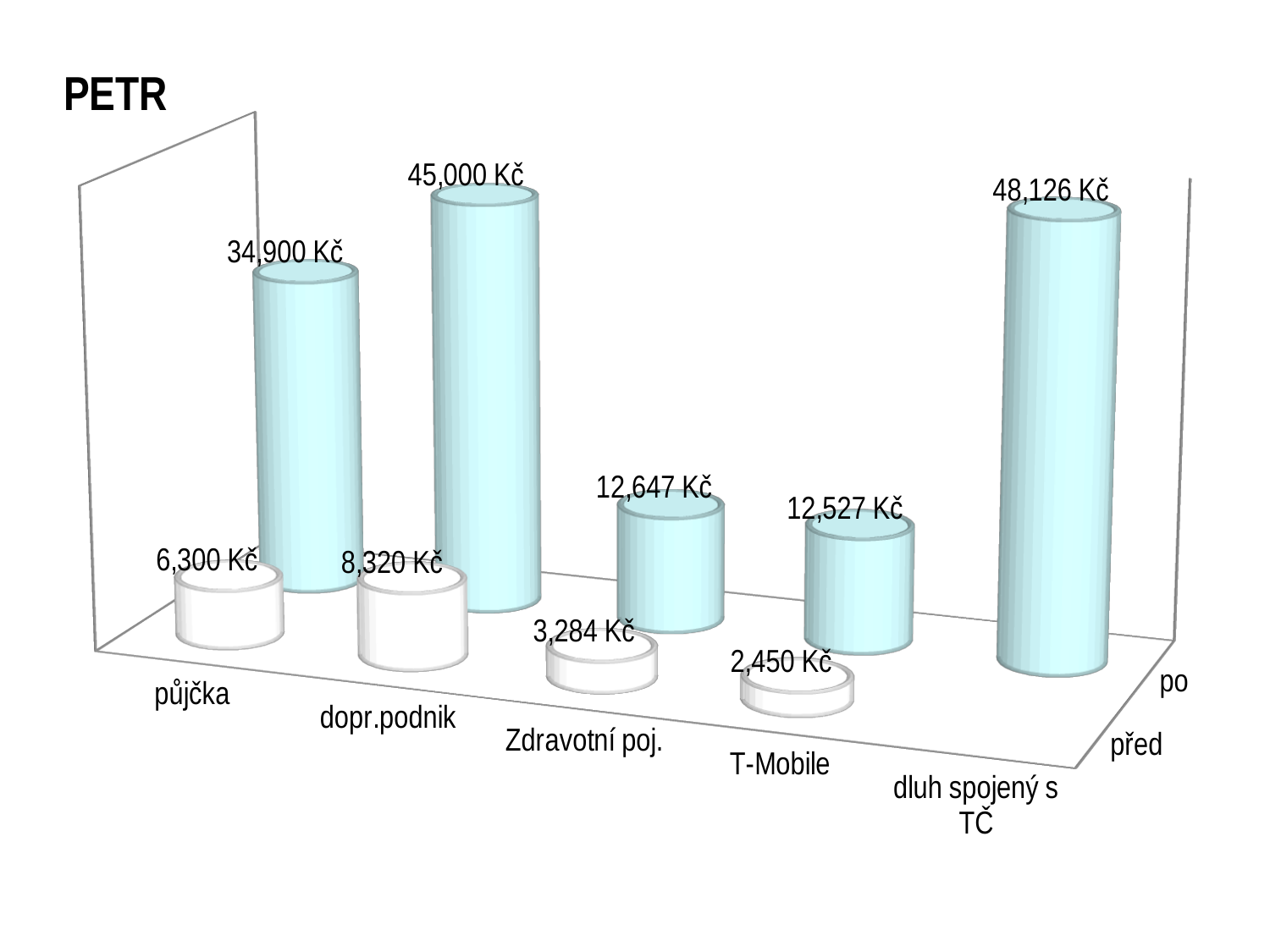
What is the 'po' value for dopr.podnik? 45,000 Kč Which category has the lowest 'před' value? T-Mobile What is the title of the chart? PETR Which is larger, the 'před' value for dopr.podnik or the 'před' value for půjčka? dopr.podnik What is the difference between the 'po' and 'před' values for půjčka? 28,600 Kč What is the 'před' value for T-Mobile? 2,450 Kč What are the two series shown on the depth axis of the chart? před and po What is the 'po' value for dluh spojený s TČ? 48,126 Kč What type of chart is shown on the slide? bar chart Which category has the highest 'po' value? dluh spojený s TČ How many categories are shown along the x axis? 5 What is the difference between the 'po' values for Zdravotní poj. and T-Mobile? 120 Kč